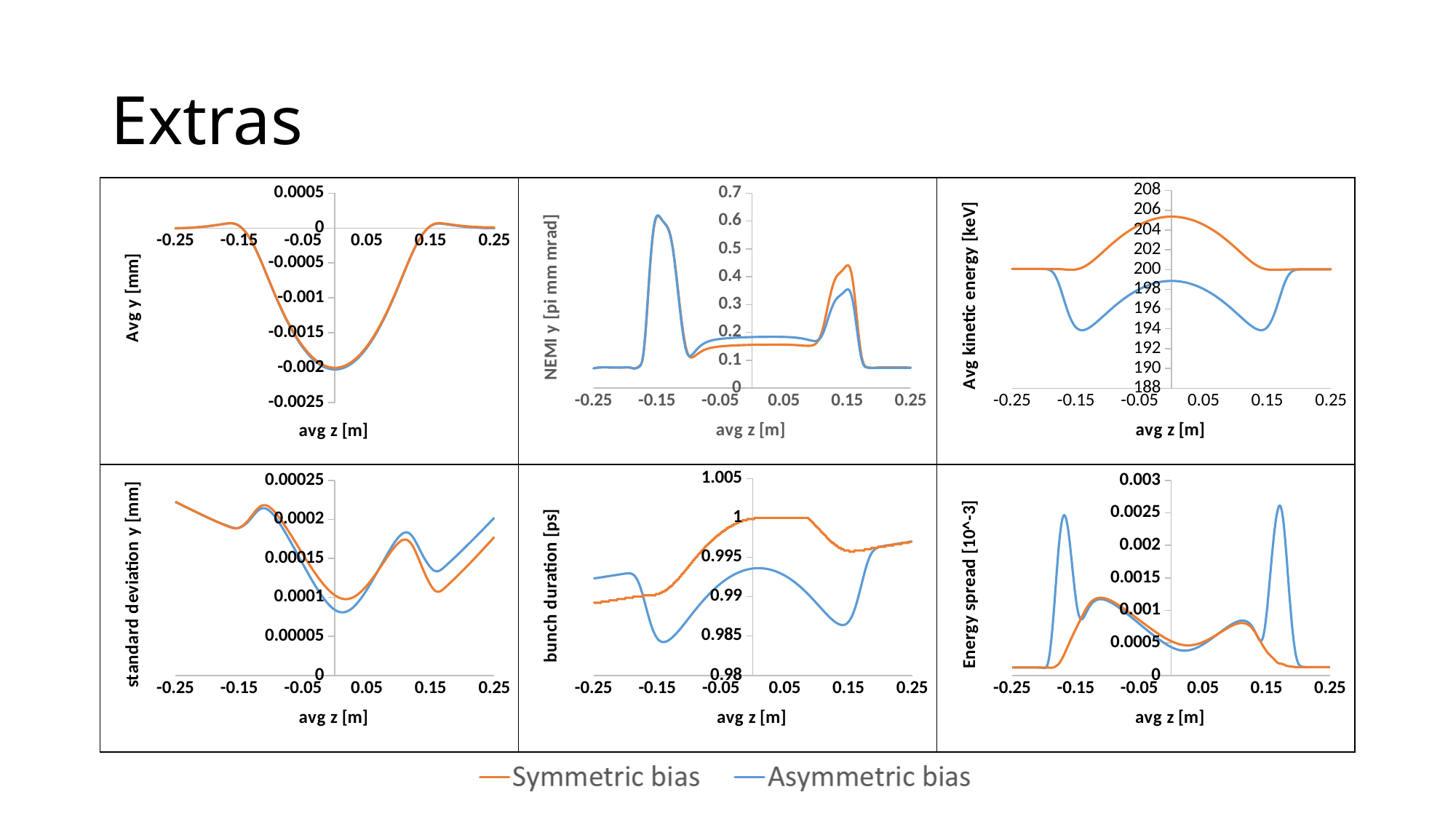
In the bunch duration [ps] chart, is the minimum value of the Asymmetric bias series greater or less than 0.99? less What are the two series named in the legend? Symmetric bias and Asymmetric bias In the standard deviation y [mm] chart, which series is higher at avg z = 0.25? Asymmetric bias In the Avg kinetic energy [keV] chart, is the peak value of the Symmetric bias series greater or less than 204? greater In the Avg kinetic energy [keV] chart, is the minimum value of the Asymmetric bias series greater or less than 196? less What is the x-axis label shared by all six charts? avg z [m] What kind of chart is the Avg kinetic energy [keV] chart? line chart In the NEMI y [pi mm mrad] chart, which series reaches the higher peak near avg z = 0.15? Symmetric bias In the Avg kinetic energy [keV] chart, which series is higher at avg z = 0? Symmetric bias How many series does the legend at the bottom of the slide list? 2